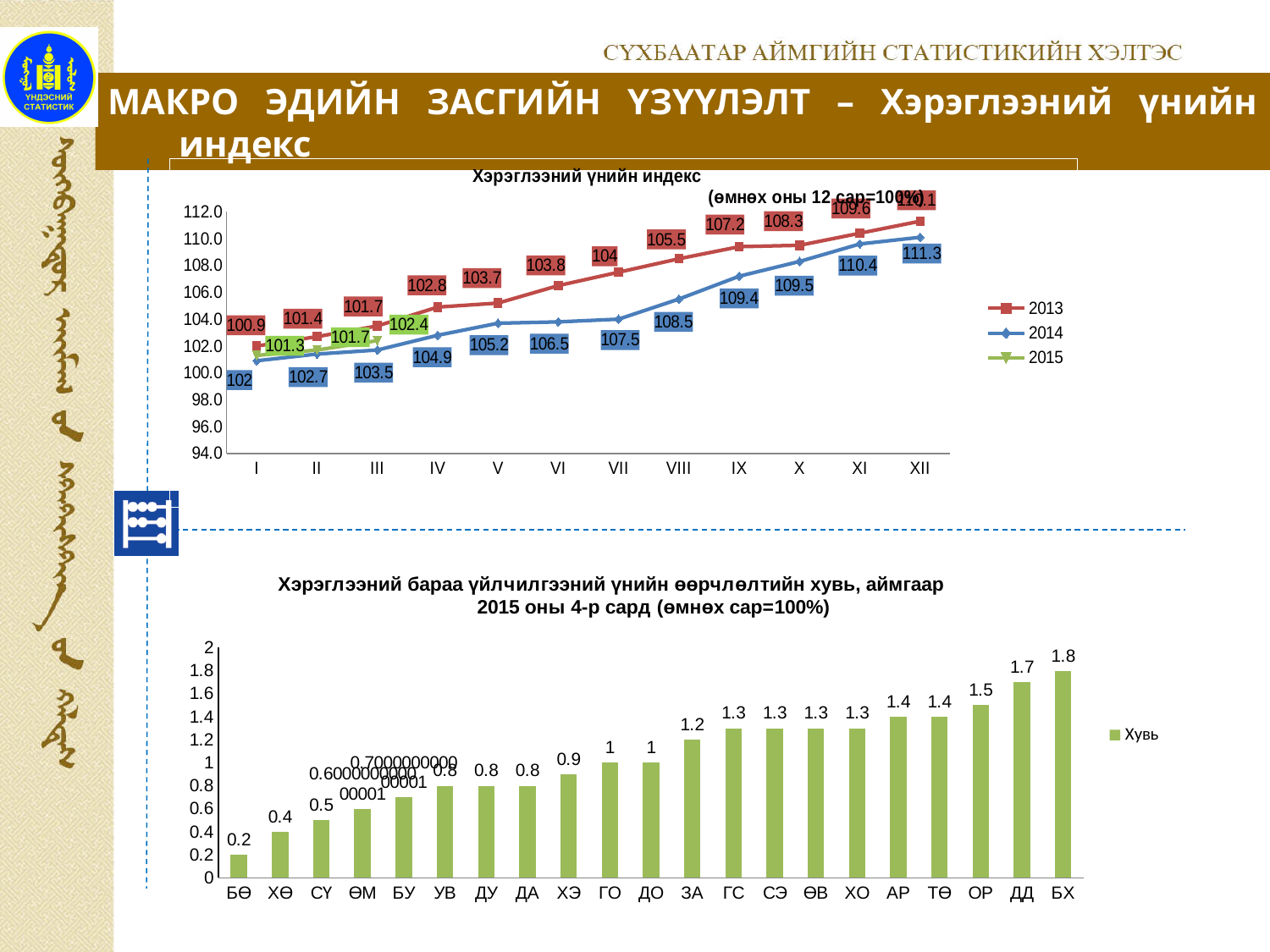
In the bottom chart, which aimag has the highest value? БХ How many series does the legend of the top chart (Хэрэглээний үнийн индекс) list? 3 In the bottom chart (Хэрэглээний бараа үйлчилгээний үнийн өөрчлөлтийн хувь, аймгаар), what is the value for БХ? 1.8 In the top chart, does the 2014 series rise or fall from month I to month XII? Rises How many aimags (categories) are shown on the x axis of the bottom chart? 21 In the bottom chart, what is the difference between the values for ДД and БӨ? 1.5 What kind of chart is the bottom chart on the slide? Bar chart In the bottom chart, which aimag has the lowest value? БӨ In the bottom chart, which is larger, the value for ЗА or the value for ХЭ? ЗА In the top chart, what is the 2015 value for month III? 102.4